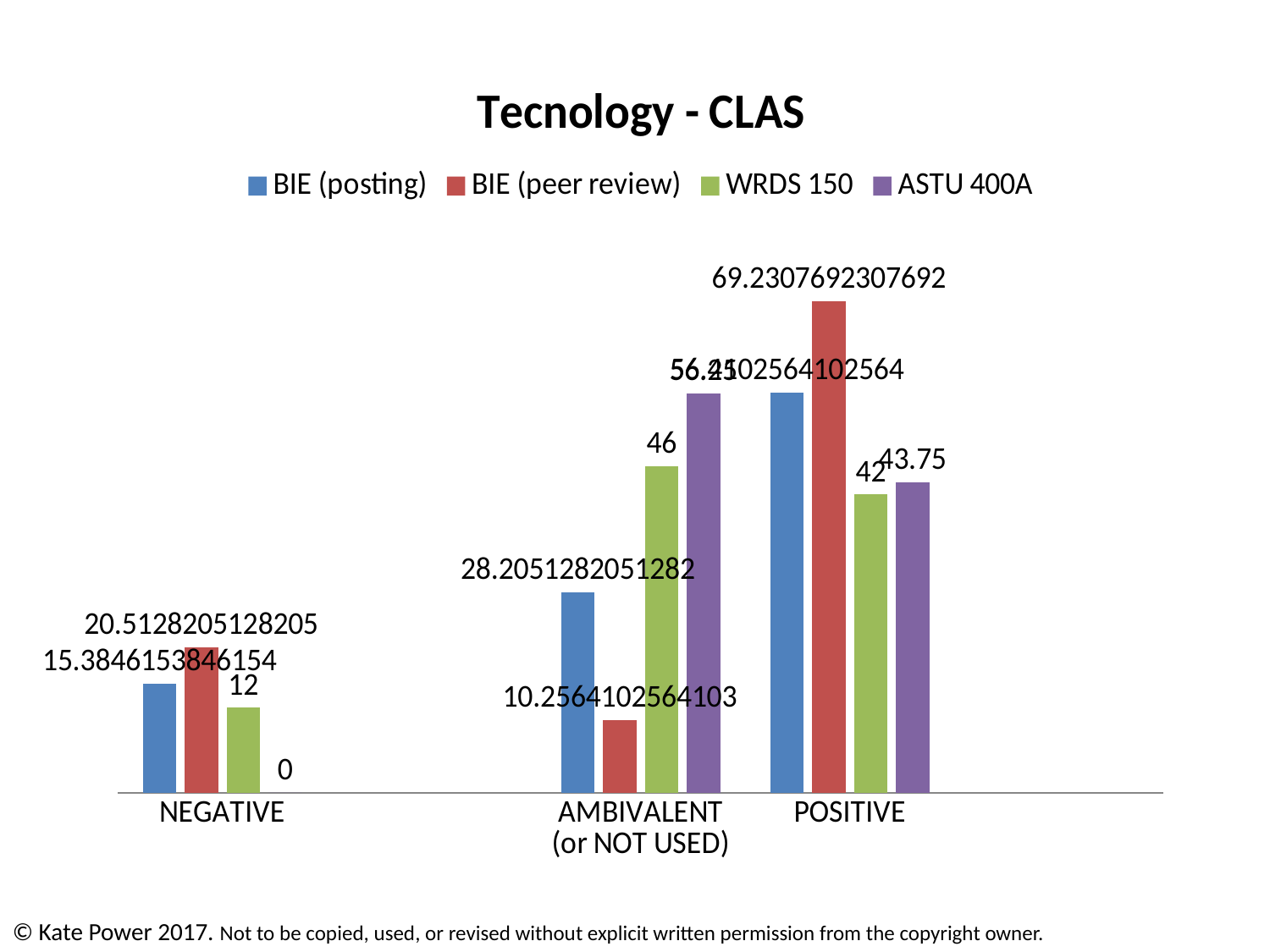
How many series does the legend list? 4 How many categories are shown on the x axis? 3 What is the value for WRDS 150 in the NEGATIVE category? 12 What is the value for WRDS 150 in the AMBIVALENT (or NOT USED) category? 46 What is the difference between the WRDS 150 values for AMBIVALENT (or NOT USED) and POSITIVE? 4 What is the value for ASTU 400A in the POSITIVE category? 43.75 What is the value for BIE (peer review) in the POSITIVE category? 69.2307692307692 In the POSITIVE category, which is larger: WRDS 150 or ASTU 400A? ASTU 400A What is the value for ASTU 400A in the NEGATIVE category? 0 What kind of chart is shown on the slide? bar chart Which series has the lowest value in the NEGATIVE category? ASTU 400A Which series has the highest value in the POSITIVE category? BIE (peer review)